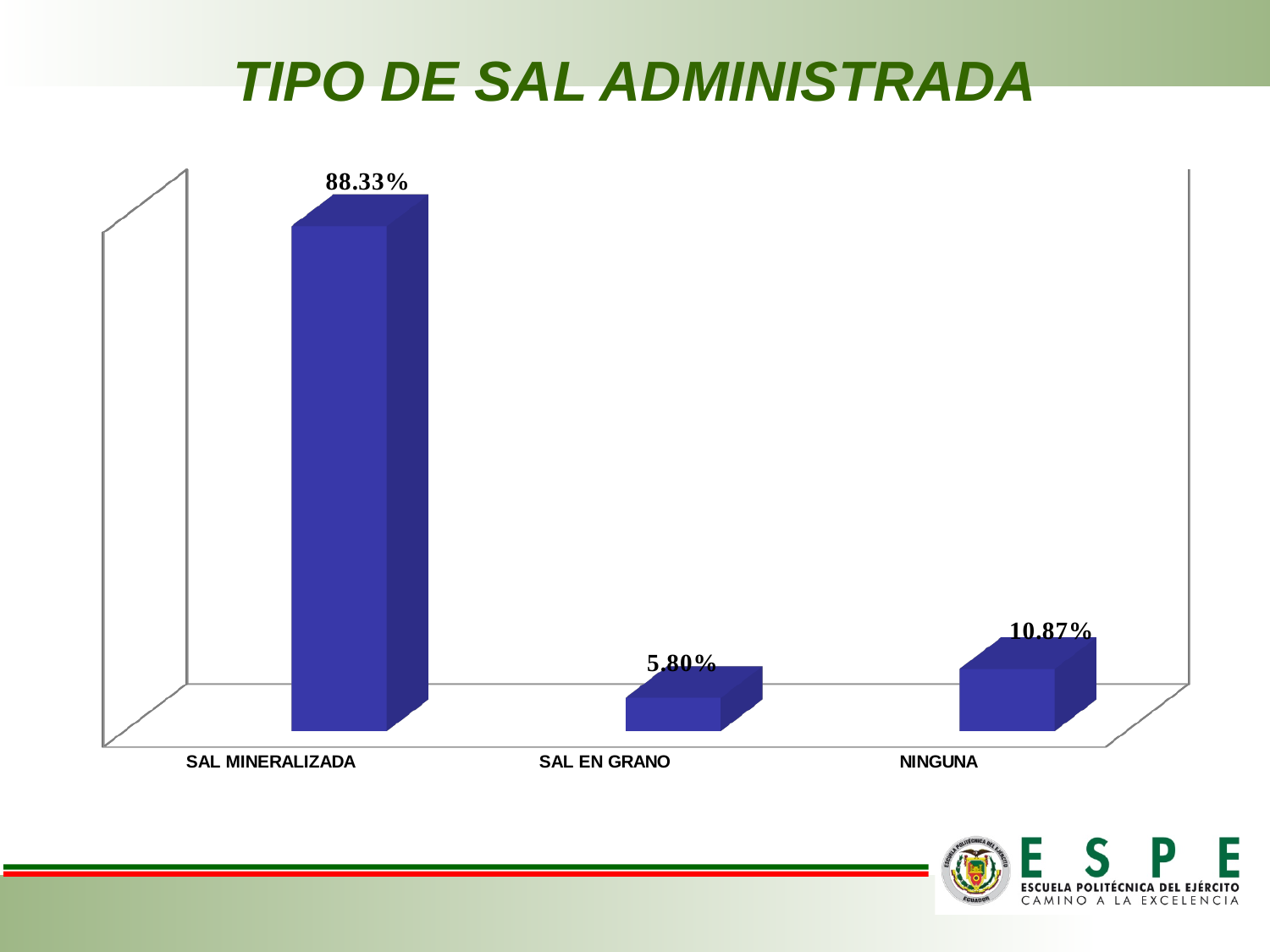
How many categories are shown in the chart? 3 What kind of chart is shown on the slide? Bar chart What is the title of the chart? TIPO DE SAL ADMINISTRADA Which category has the highest value? SAL MINERALIZADA What is the value for SAL EN GRANO? 5.80% Which category has the lowest value? SAL EN GRANO What is the difference between the values for NINGUNA and SAL EN GRANO? 5.07% What is the difference between the values for SAL MINERALIZADA and NINGUNA? 77.46% What is the value for SAL MINERALIZADA? 88.33% What is the value for NINGUNA? 10.87% Which is larger, the value for NINGUNA or the value for SAL EN GRANO? NINGUNA What colour are the bars in the chart? Blue